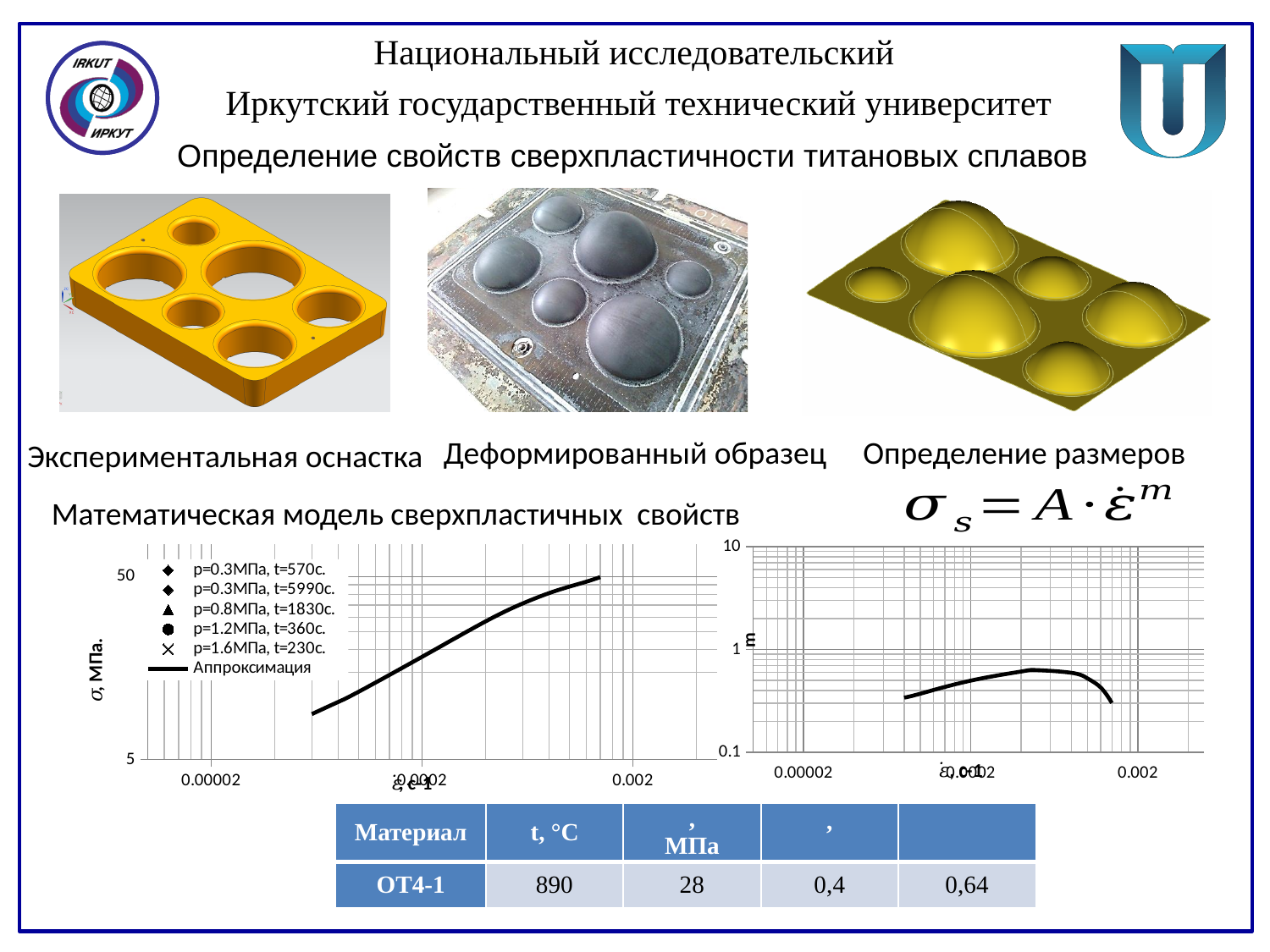
On the right chart, is the value of the curve at its left end greater or less than 0.1? greater What is the last legend entry on the left chart? Аппроксимация On the left chart, is the value of the approximation curve at its left end greater or less than 5? greater On the right chart, is the highest value of the curve greater or less than 1? less On the left chart, does the approximation curve rise or fall as the strain rate increases along the x axis? rises What is the largest tick value shown on the x axis of the left chart? 0.002 What is the largest tick value shown on the y axis of the right chart? 10 What kind of chart is the right chart (m versus strain rate)? line chart How many entries does the legend of the left chart list? 6 What kind of chart is the left chart (σ, МПа versus strain rate)? line chart What is the label of the y axis on the left chart? σ, МПа.